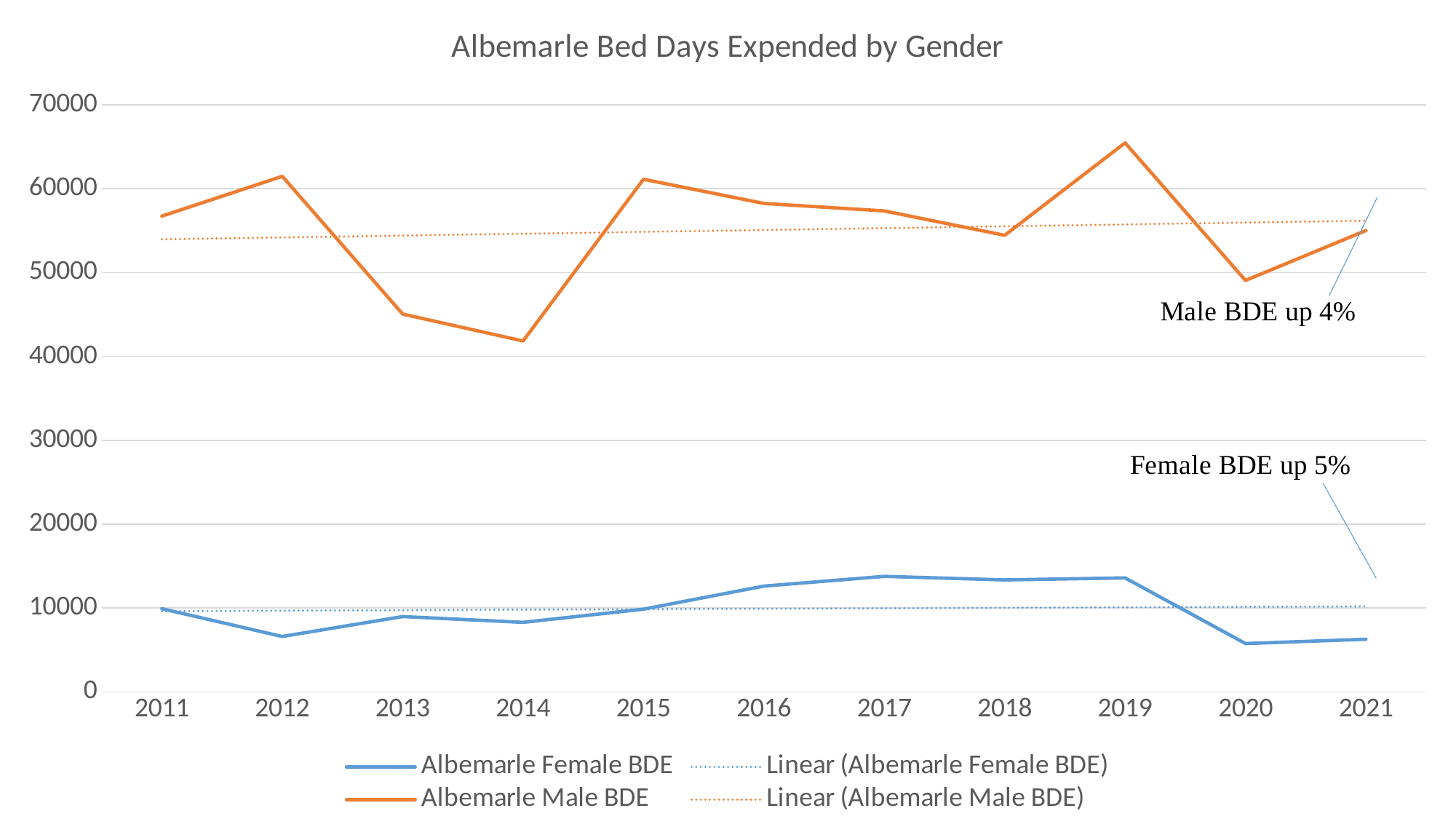
What kind of chart is shown on the slide? line chart Which is larger, Albemarle Male BDE in 2012 or in 2013? 2012 In which year is Albemarle Female BDE lowest? 2020 Is the Albemarle Female BDE value for 2020 greater or less than 10000? less Is the Albemarle Male BDE value for 2014 greater or less than 50000? less What is the title of the chart? Albemarle Bed Days Expended by Gender In which year is Albemarle Male BDE highest? 2019 How many entries does the legend list? 4 Does Albemarle Female BDE rise or fall from 2019 to 2020? fall Is the Albemarle Male BDE value for 2019 greater or less than 60000? greater How many years are plotted along the x axis? 11 In which year is Albemarle Male BDE lowest? 2014